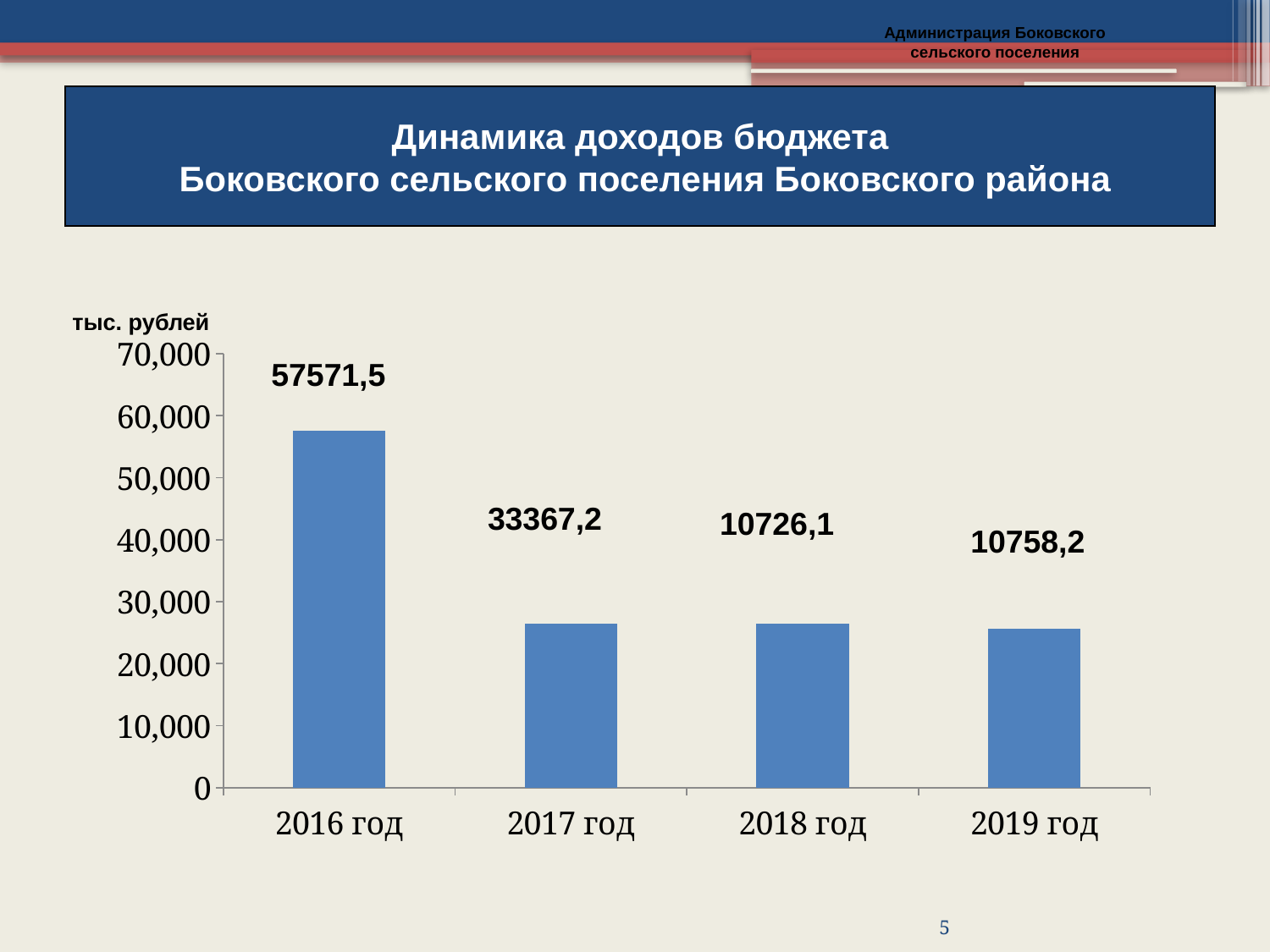
How many years are shown on the x axis? 4 Which year has the lowest labelled budget revenue? 2018 год In what units are the values on the chart expressed? тыс. рублей What is the budget revenue value shown for 2016 год? 57571,5 What is the budget revenue value shown for 2017 год? 33367,2 Which year has the highest budget revenue? 2016 год What is the difference between the labelled values for 2016 год and 2017 год? 24204,3 Is the value for 2016 год greater or less than 50,000? greater Which is larger, the value for 2017 год or the value for 2018 год? 2017 год What kind of chart is shown on the slide? bar chart What is the budget revenue value shown for 2019 год? 10758,2 What is the budget revenue value shown for 2018 год? 10726,1